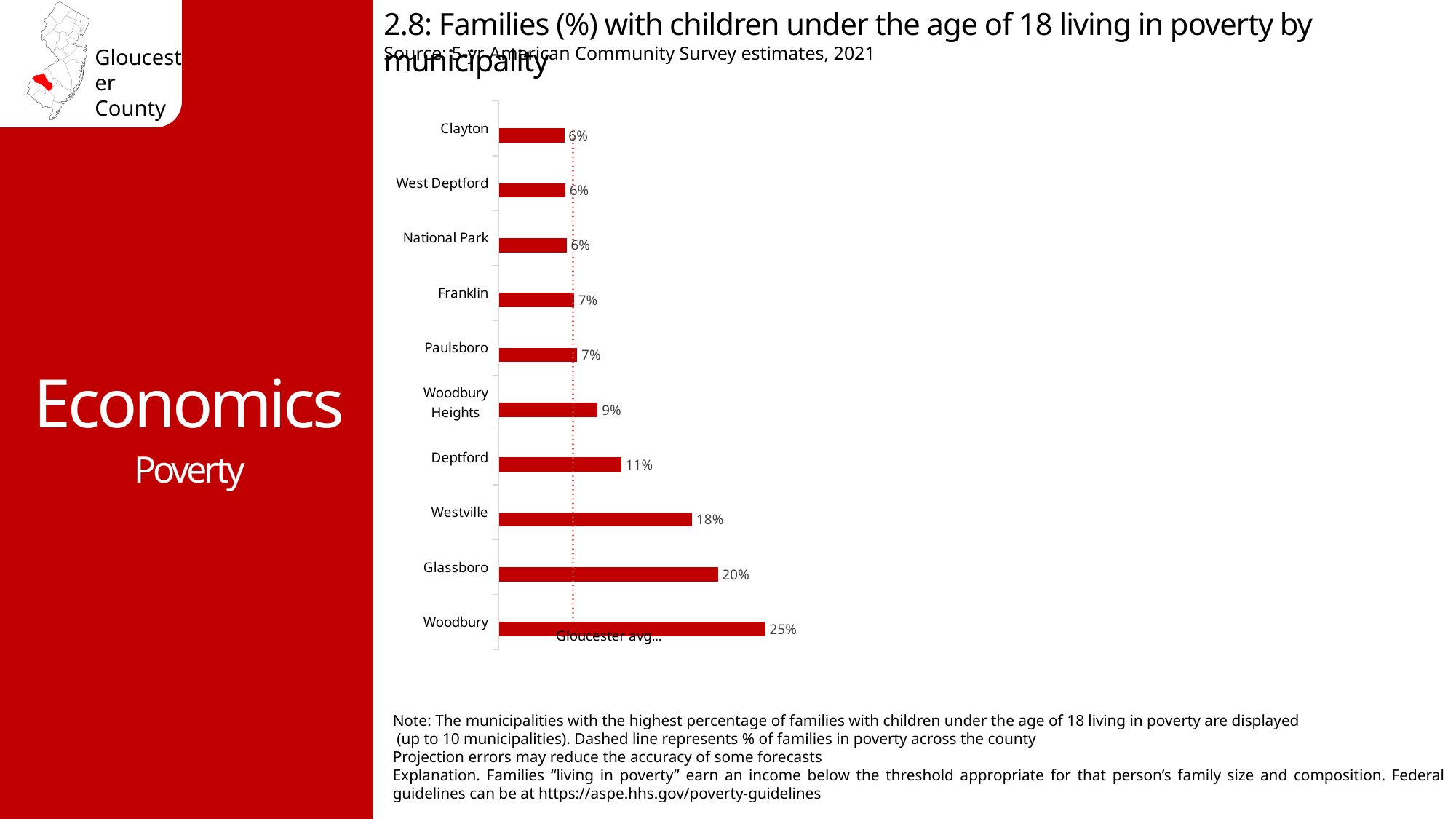
How many municipalities are shown in the chart? 10 What is the difference between the values for Glassboro and Deptford? 9% What is the value shown for Woodbury Heights? 9% Which has a higher value, Westville or Paulsboro? Westville Which municipality has the highest percentage of families with children living in poverty? Woodbury Which has a higher value, Deptford or Woodbury Heights? Deptford What is the difference between the values for Woodbury and Westville? 7% What is the value shown for Deptford? 11% What is the value shown for Glassboro? 20% What does the dashed vertical line on the chart represent? Gloucester County average (% of families in poverty across the county) What kind of chart is shown on the slide? Bar chart What percentage of families with children under 18 are living in poverty in Woodbury? 25%